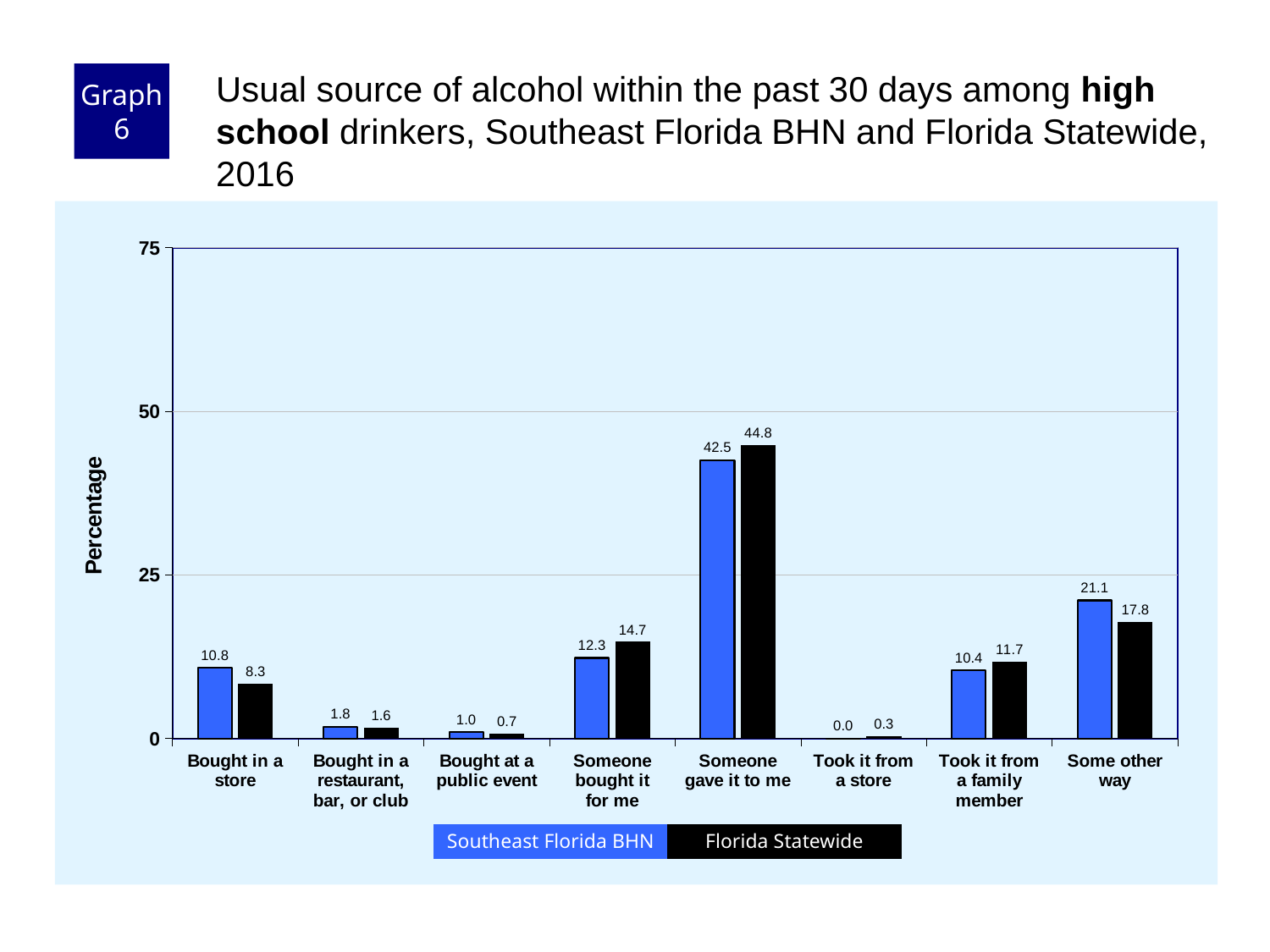
Is the Southeast Florida BHN value for "Someone gave it to me" greater or less than 50? less What is the Florida Statewide value for "Took it from a store"? 0.3 What is the label of the y axis? Percentage What is the Southeast Florida BHN value for "Someone gave it to me"? 42.5 How many categories are shown on the x axis? 8 What is the difference between the Florida Statewide and Southeast Florida BHN values for "Someone gave it to me"? 2.3 How many series does the legend list? 2 What is the Florida Statewide value for "Bought in a store"? 8.3 Which category has the lowest Southeast Florida BHN value? Took it from a store For "Some other way", which is larger: Southeast Florida BHN or Florida Statewide? Southeast Florida BHN Which category has the highest Florida Statewide value? Someone gave it to me What kind of chart is shown on the slide? bar chart